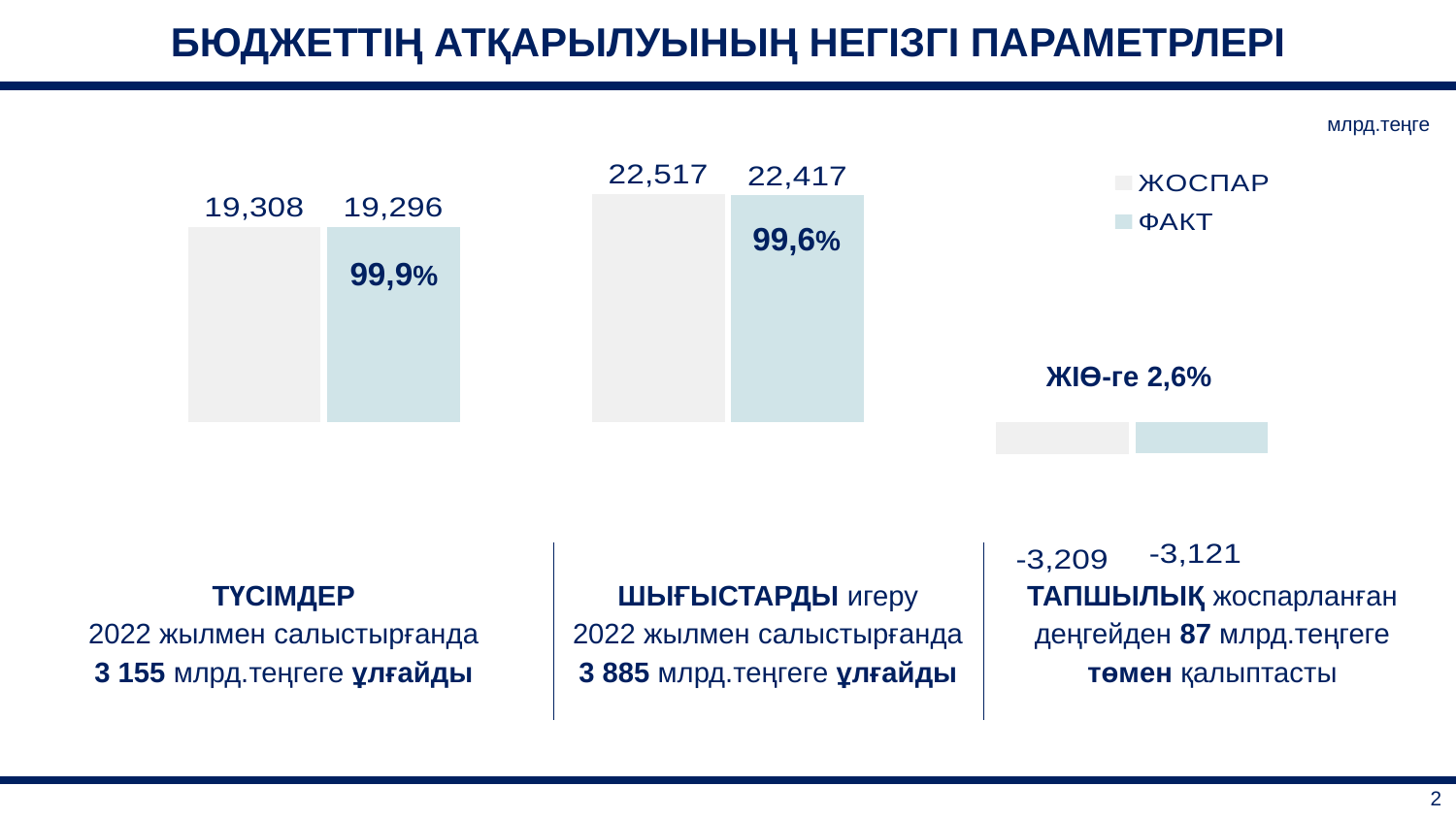
In the middle chart (ШЫҒЫСТАР), what is the difference between the ЖОСПАР and ФАКТ values? 100 How many series does the legend list? 2 In the middle chart (ШЫҒЫСТАР), which is larger, ЖОСПАР or ФАКТ? ЖОСПАР In the right chart (ТАПШЫЛЫҚ), what is the value of the ФАКТ bar? -3,121 In the left chart (ТҮСІМДЕР), what is the difference between the ЖОСПАР and ФАКТ values? 12 In the right chart (ТАПШЫЛЫҚ), what is the value of the ЖОСПАР bar? -3,209 What percentage is printed on the ФАКТ bar of the left chart (ТҮСІМДЕР)? 99,9% In the left chart (ТҮСІМДЕР), what is the value of the ФАКТ bar? 19,296 What type of chart is used for the left chart (ТҮСІМДЕР)? Bar chart In the middle chart (ШЫҒЫСТАР), what is the value of the ЖОСПАР bar? 22,517 In the middle chart (ШЫҒЫСТАР), what is the value of the ФАКТ bar? 22,417 In the left chart (ТҮСІМДЕР), what is the value of the ЖОСПАР bar? 19,308